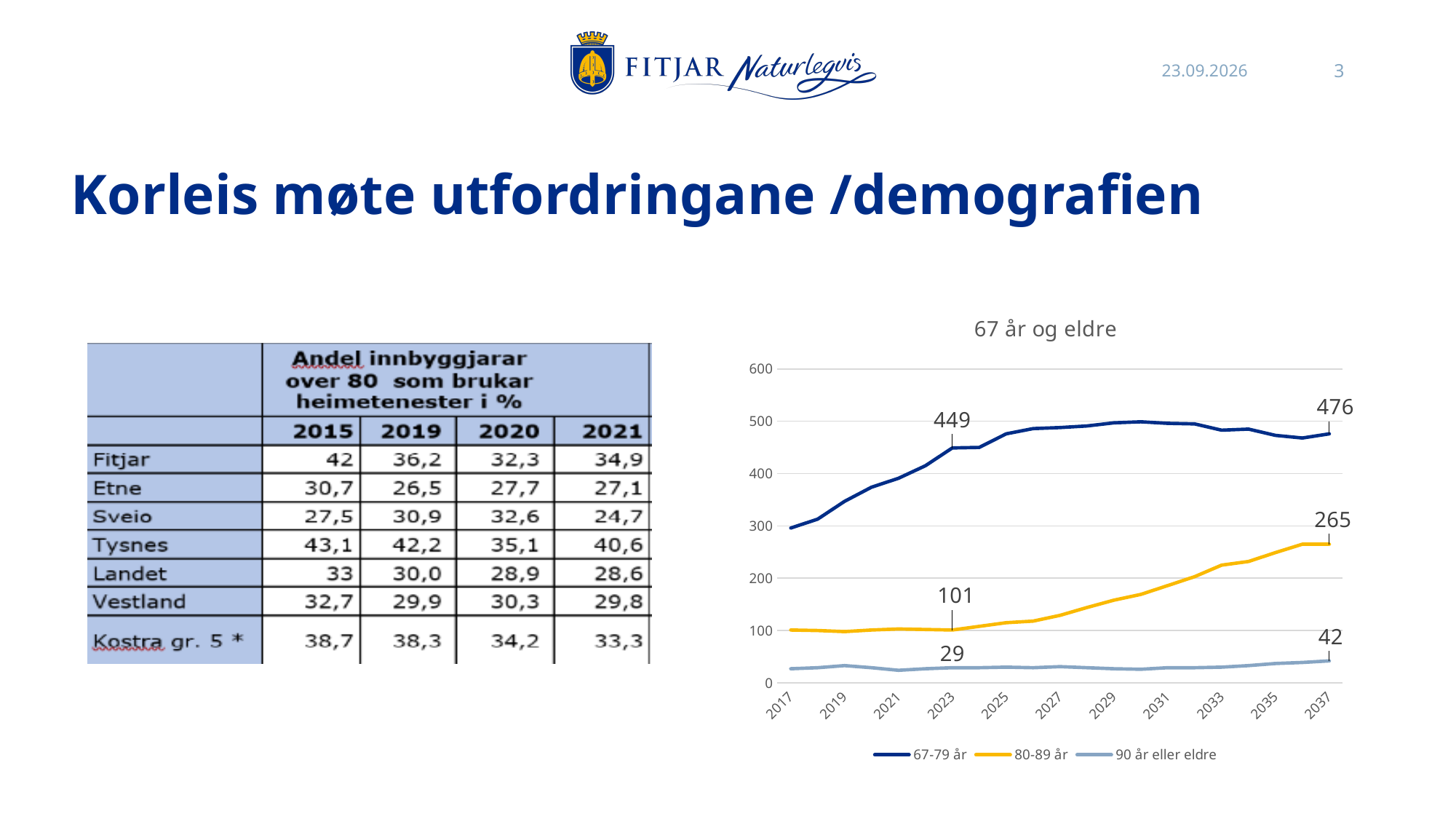
What is the value for the 90 år eller eldre series in 2023? 29 What is the value for the 67-79 år series in 2037? 476 What is the value for the 80-89 år series in 2023? 101 What kind of chart is shown on the slide? line chart By how much does the 67-79 år series increase from 2023 to 2037? 27 What is the value for the 90 år eller eldre series in 2037? 42 By how much does the 80-89 år series increase from 2023 to 2037? 164 Is the value for the 80-89 år series in 2017 greater or less than 200? less How many series does the legend of the chart list? 3 Which series has the highest value in 2037? 67-79 år What is the title of the chart? 67 år og eldre In 2037, which is larger: the 80-89 år series or the 90 år eller eldre series? 80-89 år